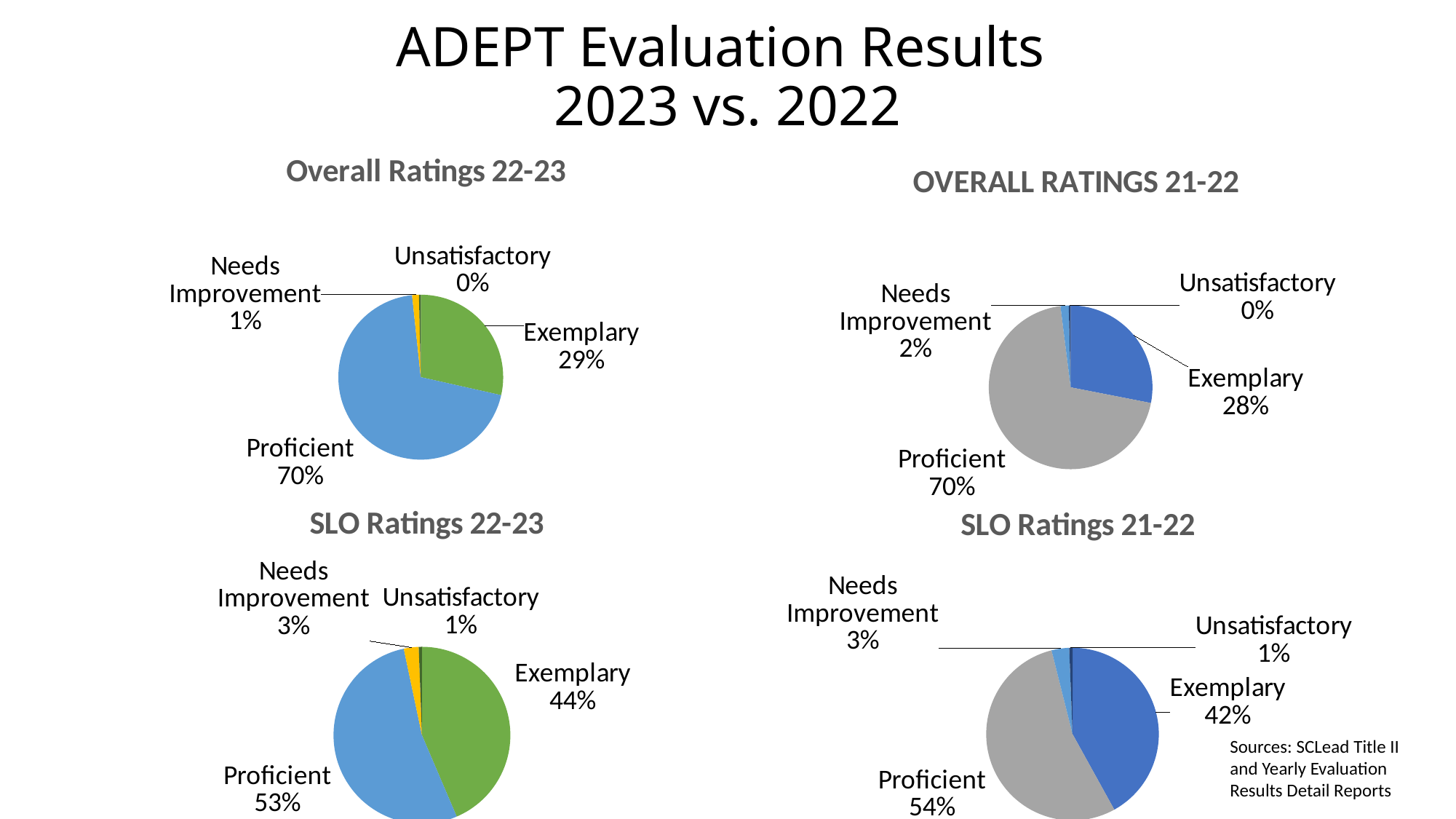
In the 'Overall Ratings 22-23' chart, which category has the smallest share? Unsatisfactory How many categories does the 'SLO Ratings 22-23' chart show? 4 In the 'OVERALL RATINGS 21-22' chart, which is larger, Needs Improvement or Exemplary? Exemplary How many charts are on the slide? 4 What type of chart is 'Overall Ratings 22-23'? Pie chart In the 'Overall Ratings 22-23' chart, what percentage is Proficient? 70% In the 'SLO Ratings 22-23' chart, what is the difference between the Proficient and Exemplary percentages? 9% In the 'SLO Ratings 21-22' chart, which category has the largest share? Proficient What is the title of the chart in the bottom-right of the slide? SLO Ratings 21-22 In the 'SLO Ratings 21-22' chart, what percentage is Needs Improvement? 3% In the 'OVERALL RATINGS 21-22' chart, what percentage is Exemplary? 28% In the 'SLO Ratings 22-23' chart, what percentage is Exemplary? 44%